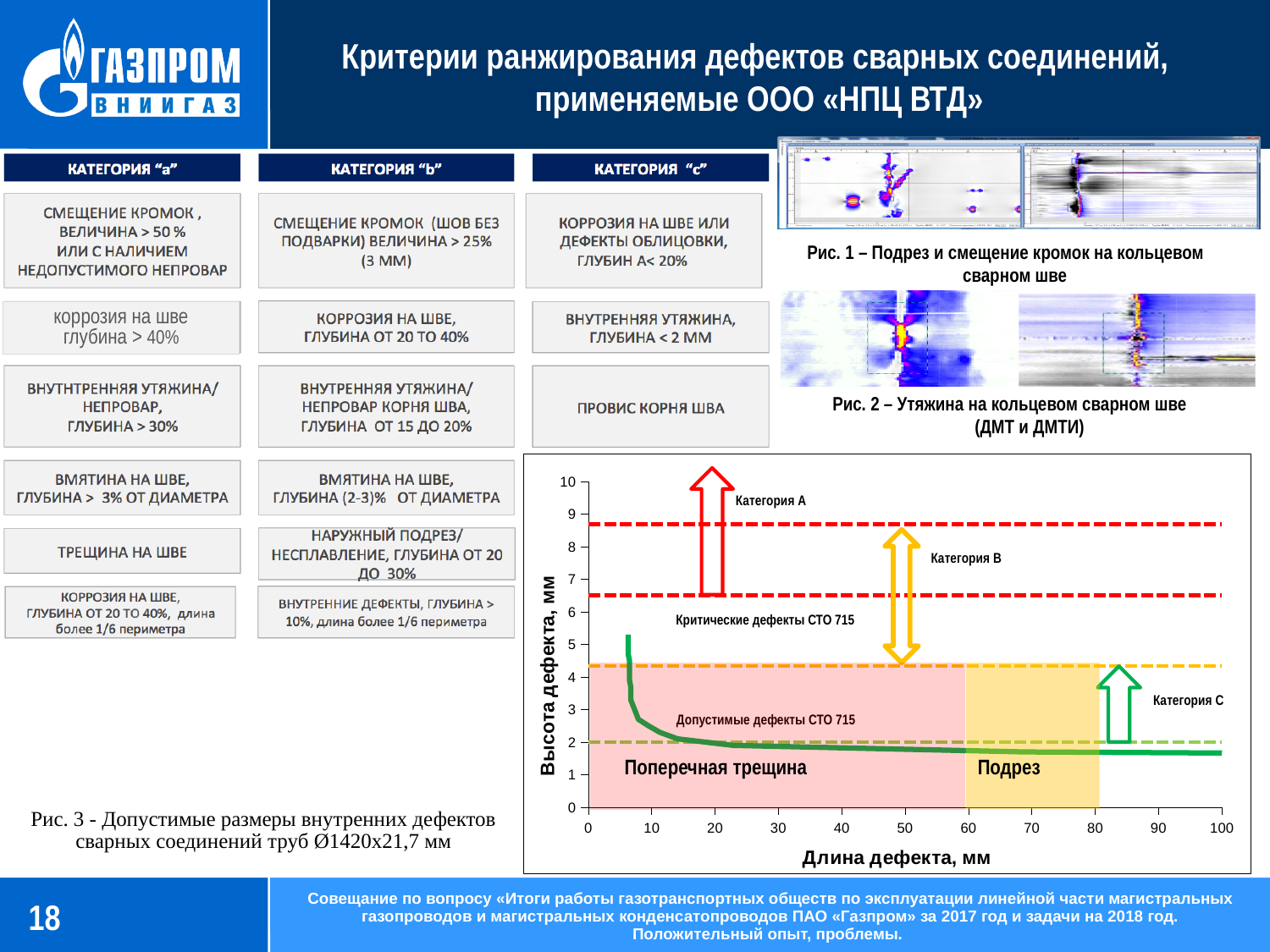
In the chart Рис. 3, is the upper red dashed line (boundary of Категория A) greater or less than 8 on the y axis? greater In the chart Рис. 3, is the height of the green curve at a defect length of 20 mm greater or less than 5? less In the chart Рис. 3, does the green curve rise or fall as defect length increases along the x axis? fall What is the title of the x axis of the chart Рис. 3? Длина дефекта, мм What is the title of the y axis of the chart Рис. 3? Высота дефекта, мм In the chart Рис. 3, what is the maximum value shown on the x axis? 100 In the chart Рис. 3, is the lower red dashed line greater or less than 6 on the y axis? greater What kind of chart is shown at the bottom right of the slide (Рис. 3)? line chart In the chart Рис. 3, what is the maximum value shown on the y axis? 10